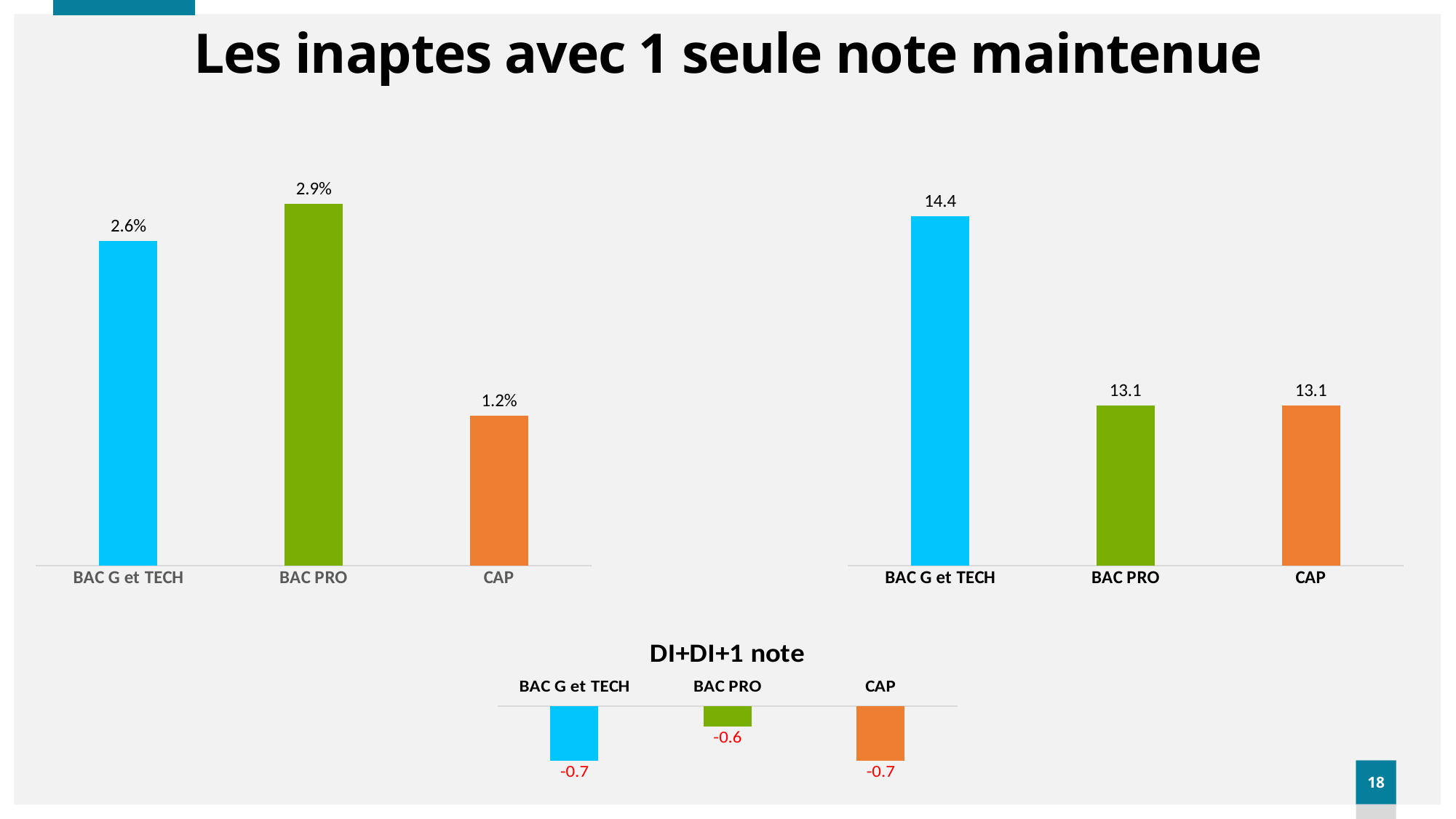
In the top-left chart, what is the value for CAP? 1.2% In the bottom chart titled 'DI+DI+1 note', what is the value for CAP? -0.7 In the top-right chart, what is the value for BAC G et TECH? 14.4 In the top-left chart, which category has the lowest value? CAP How many categories are shown in the top-right chart? 3 In the top-left chart, which category has the highest value? BAC PRO What kind of chart is the bottom chart titled 'DI+DI+1 note'? Bar chart In the top-left chart, what is the difference between the values for BAC PRO and BAC G et TECH? 0.3% In the bottom chart titled 'DI+DI+1 note', what is the value for BAC PRO? -0.6 In the top-right chart, which category has the highest value? BAC G et TECH In the top-left chart, what is the value for BAC PRO? 2.9% In the top-right chart, what is the difference between the values for BAC G et TECH and CAP? 1.3